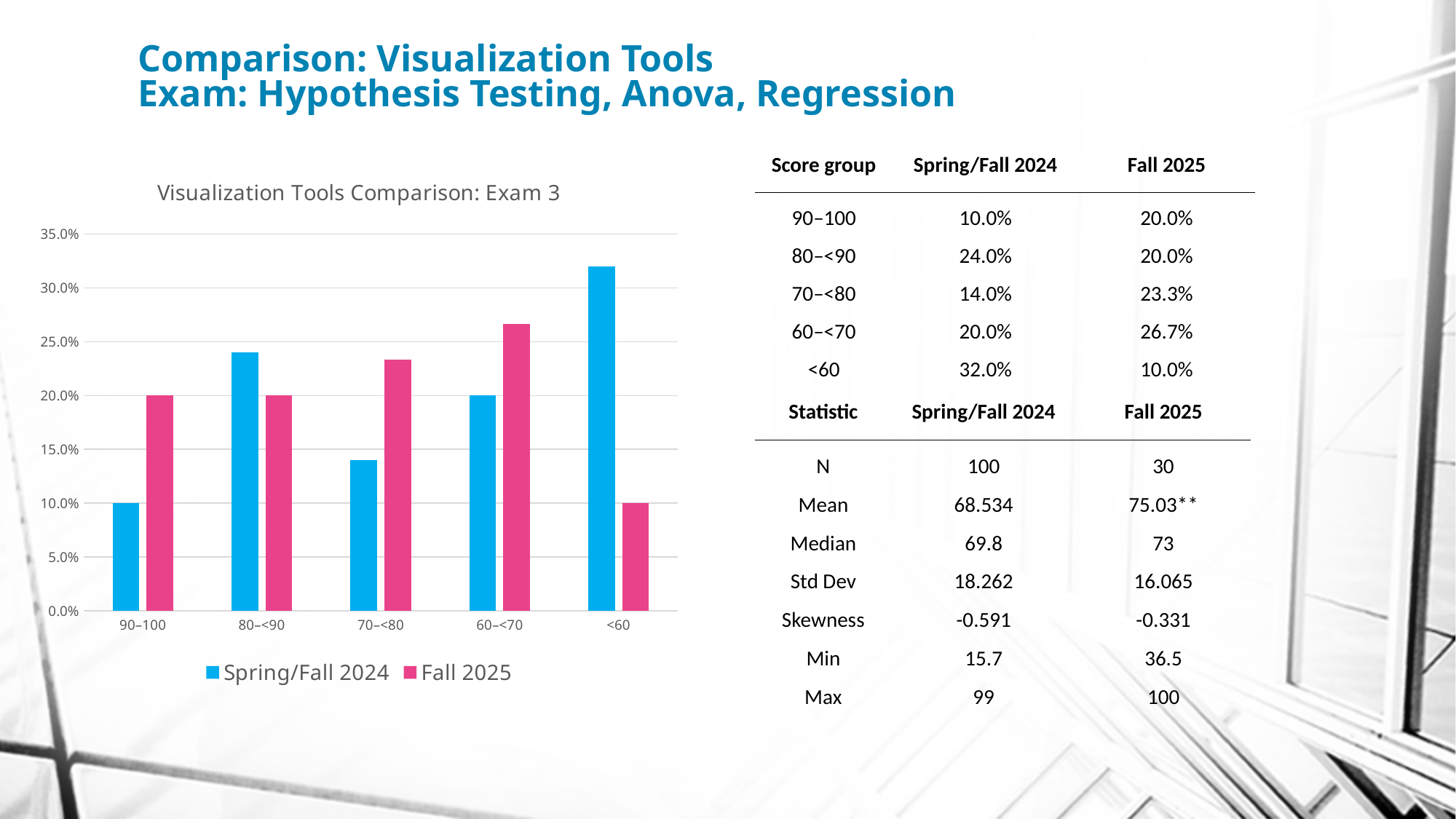
What is the difference between the Fall 2025 and Spring/Fall 2024 values for the 90–100 score group? 10.0% What is the Spring/Fall 2024 value for the 90–100 score group? 10.0% How many series does the chart legend list? 2 What kind of chart is shown on the slide? bar chart What is the title of the chart? Visualization Tools Comparison: Exam 3 For the 70–<80 score group, which series has the larger value, Spring/Fall 2024 or Fall 2025? Fall 2025 How many score groups are shown on the x axis of the chart? 5 What is the Fall 2025 value for the 80–<90 score group? 20.0% Which score group has the highest Spring/Fall 2024 value? <60 What is the Fall 2025 value for the <60 score group? 10.0% Which score group has the lowest Fall 2025 value? <60 Is the Spring/Fall 2024 value for the <60 score group greater or less than 30.0%? greater